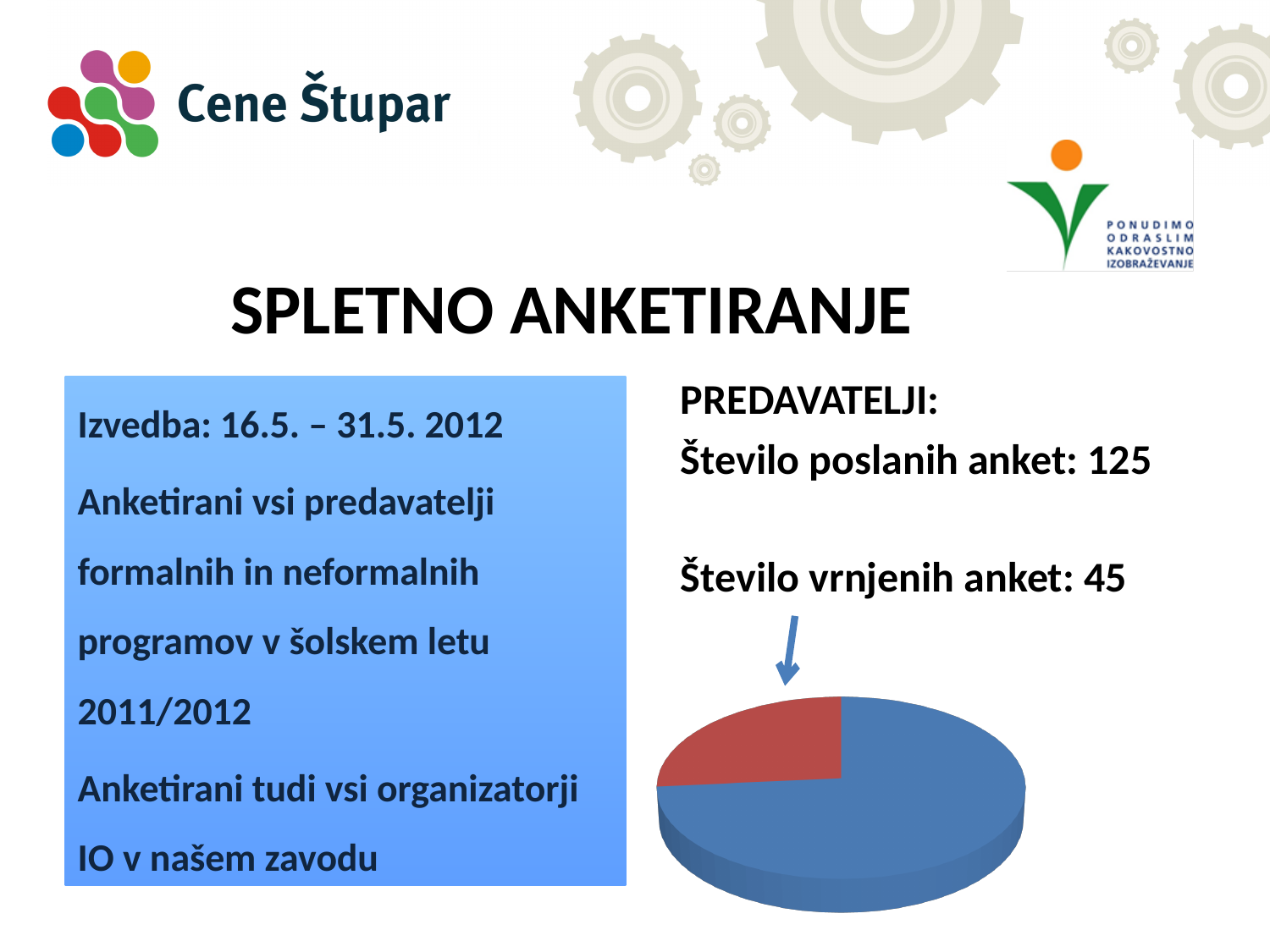
Does the red slice take up more or less than half of the pie chart? less How many slices does the pie chart have? 2 What colour is the smallest slice of the pie chart? red Is the pie chart drawn in 3D or flat 2D? 3D Which slice of the pie chart is larger, the blue one or the red one? the blue one What kind of chart is shown on the slide? pie chart What colour is the largest slice of the pie chart? blue Does the pie chart display a legend? No